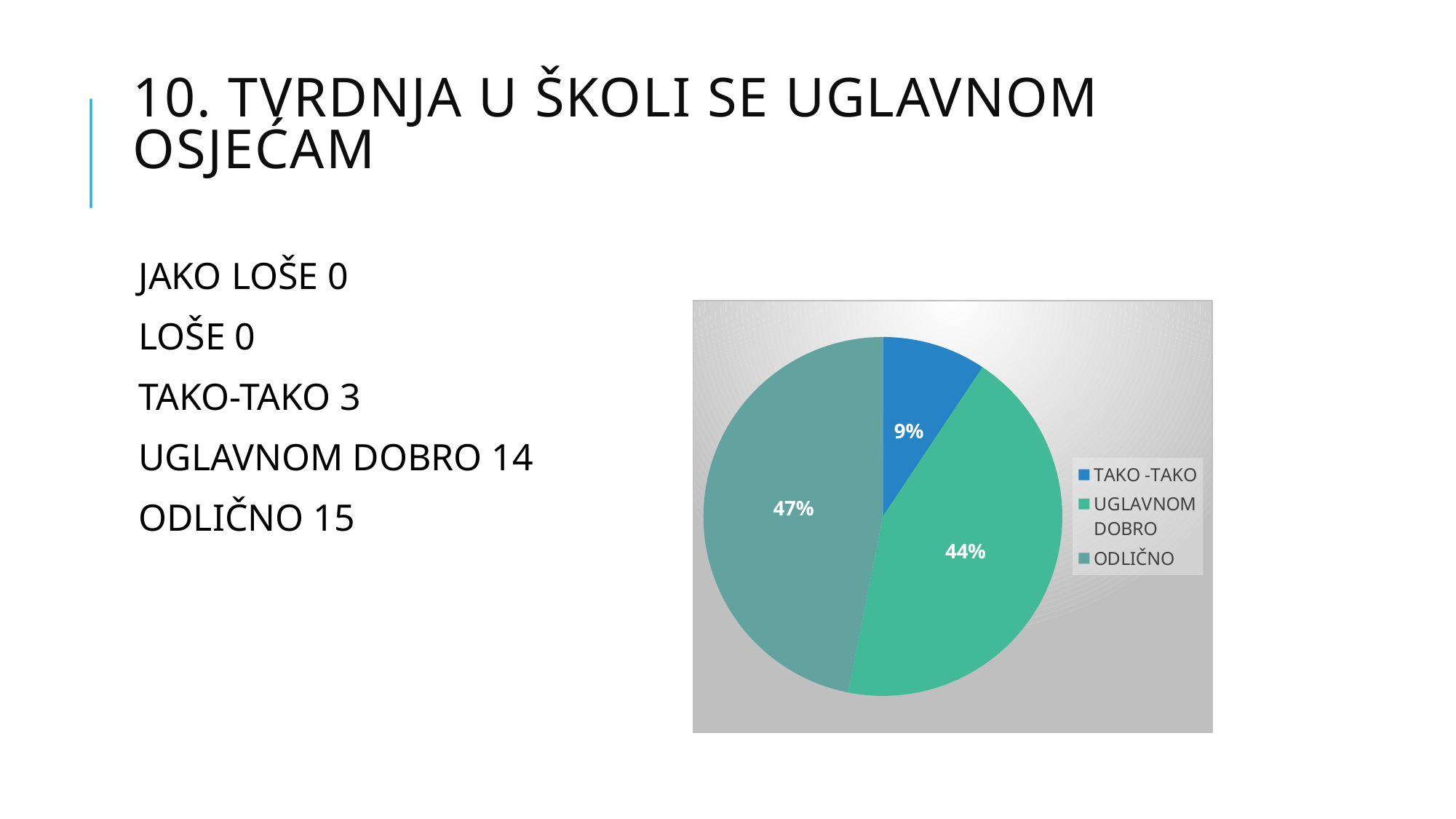
Which slice of the pie chart is the largest? ODLIČNO What kind of chart is shown on the slide? Pie chart What percentage is shown for the TAKO-TAKO slice? 9% What colour is the TAKO-TAKO slice in the pie chart? Blue What percentage is shown for the UGLAVNOM DOBRO slice? 44% What is the difference in percentage points between the UGLAVNOM DOBRO and TAKO-TAKO slices? 35 percentage points How many slices does the pie chart have? 3 What is the difference in percentage points between the ODLIČNO and UGLAVNOM DOBRO slices? 3 percentage points How many entries does the chart legend list? 3 Which slice is larger, UGLAVNOM DOBRO or TAKO-TAKO? UGLAVNOM DOBRO Which slice of the pie chart is the smallest? TAKO-TAKO What percentage is shown for the ODLIČNO slice? 47%